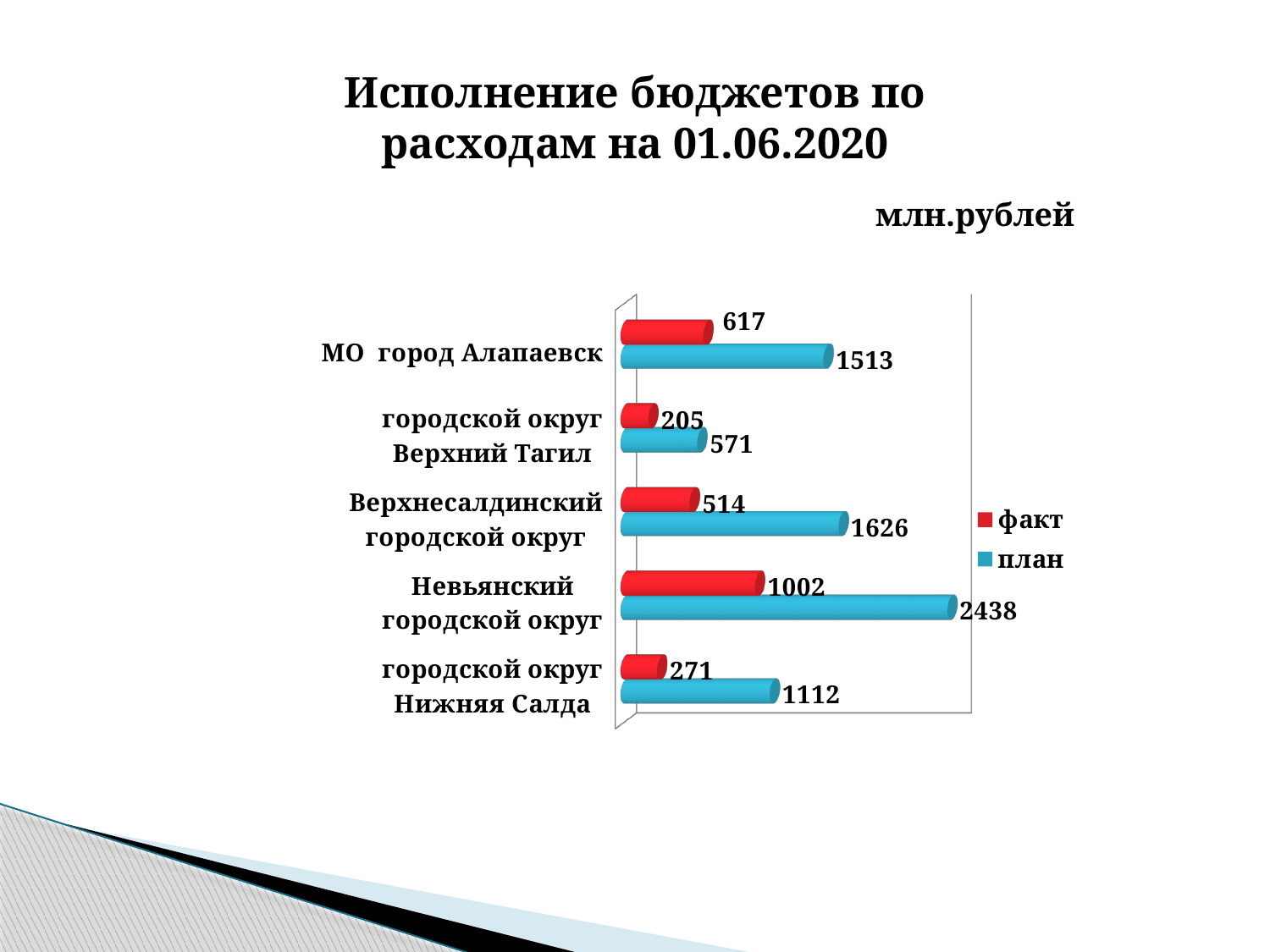
How many series does the legend list? 2 What is the факт value for городской округ Нижняя Салда? 271 What unit is stated for the values in the chart? млн.рублей What is the план value for городской округ Верхний Тагил? 571 What is the difference between the план and факт values for Верхнесалдинский городской округ? 1112 What kind of chart is shown on the slide? bar chart What is the факт value for МО город Алапаевск? 617 Which category has the highest план value? Невьянский городской округ Which category has the lowest факт value? городской округ Верхний Тагил How many categories are shown in the chart? 5 Which is larger: the факт value for МО город Алапаевск or the факт value for Верхнесалдинский городской округ? МО город Алапаевск What is the план value for Невьянский городской округ? 2438